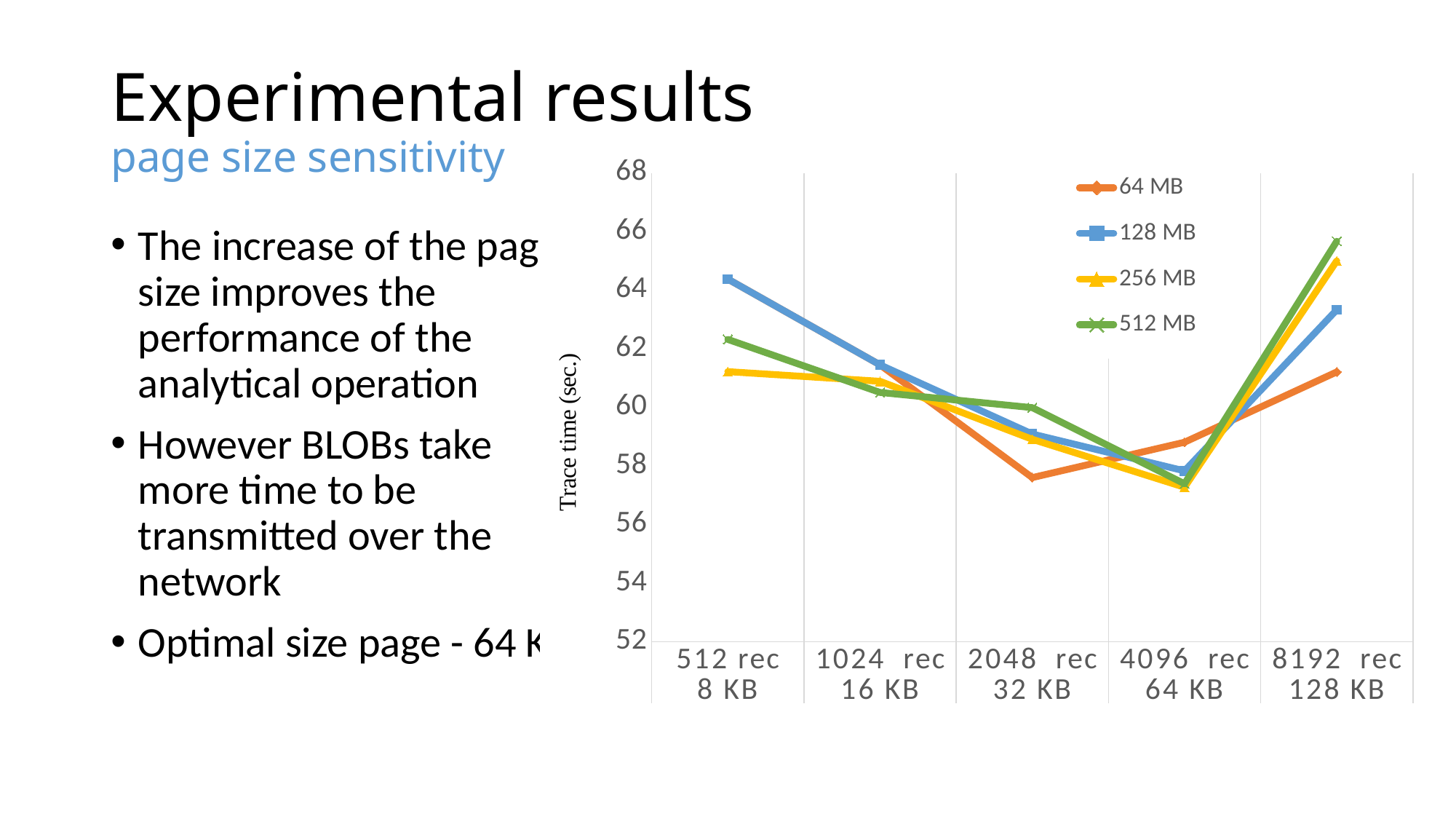
How many series does the chart legend list? 4 Which series has the lowest trace time at 8192 rec 128 KB? 64 MB Is the value for 128 MB at 512 rec 8 KB greater or less than 62? greater Is the value for 512 MB at 8192 rec 128 KB greater or less than 64? greater Is the value for 256 MB at 4096 rec 64 KB greater or less than 58? less What kind of chart is shown on the slide? line chart What is the title of the vertical axis of the chart? Trace time (sec.) How many page-size categories are shown on the x axis of the chart? 5 Which series does the chart legend list first? 64 MB For the 512 MB series, is the trace time larger at 512 rec 8 KB or at 8192 rec 128 KB? 8192 rec 128 KB